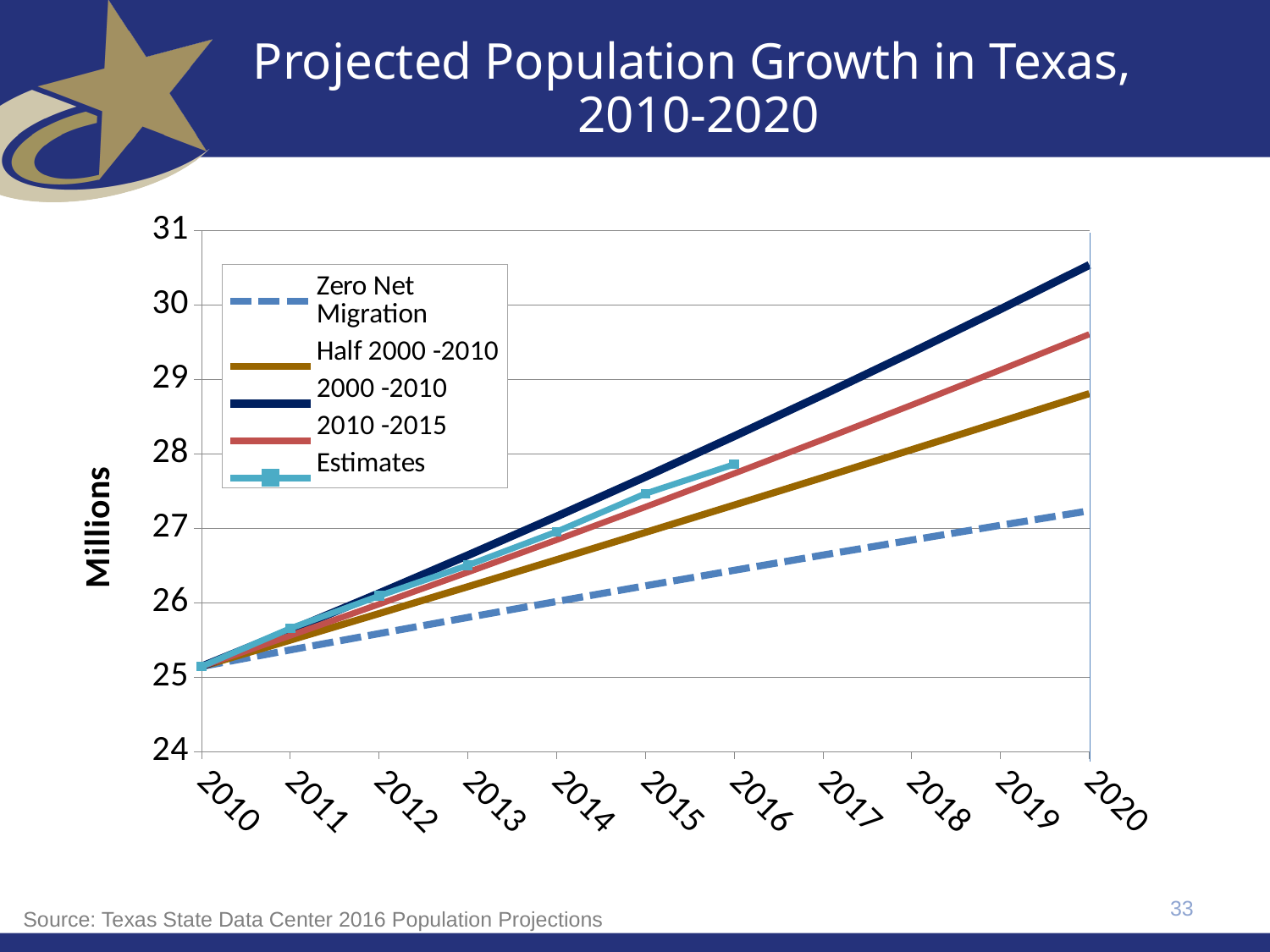
How many series does the legend list? 5 Is the value of the Zero Net Migration series in 2020 greater or less than 28? less Do the values of the 2000 -2010 series rise or fall from 2010 to 2020? rise Is the value of the Half 2000 -2010 series in 2020 greater or less than 29? less In 2020, which is larger: the 2010 -2015 series or the Half 2000 -2010 series? 2010 -2015 What is the label on the y axis? Millions Which series has the highest value in 2020? 2000 -2010 Is the value of the Estimates series in 2016 greater or less than 28? less How many years are labelled along the x axis? 11 Which series has the lowest value in 2020? Zero Net Migration What kind of chart is shown on the slide? line chart